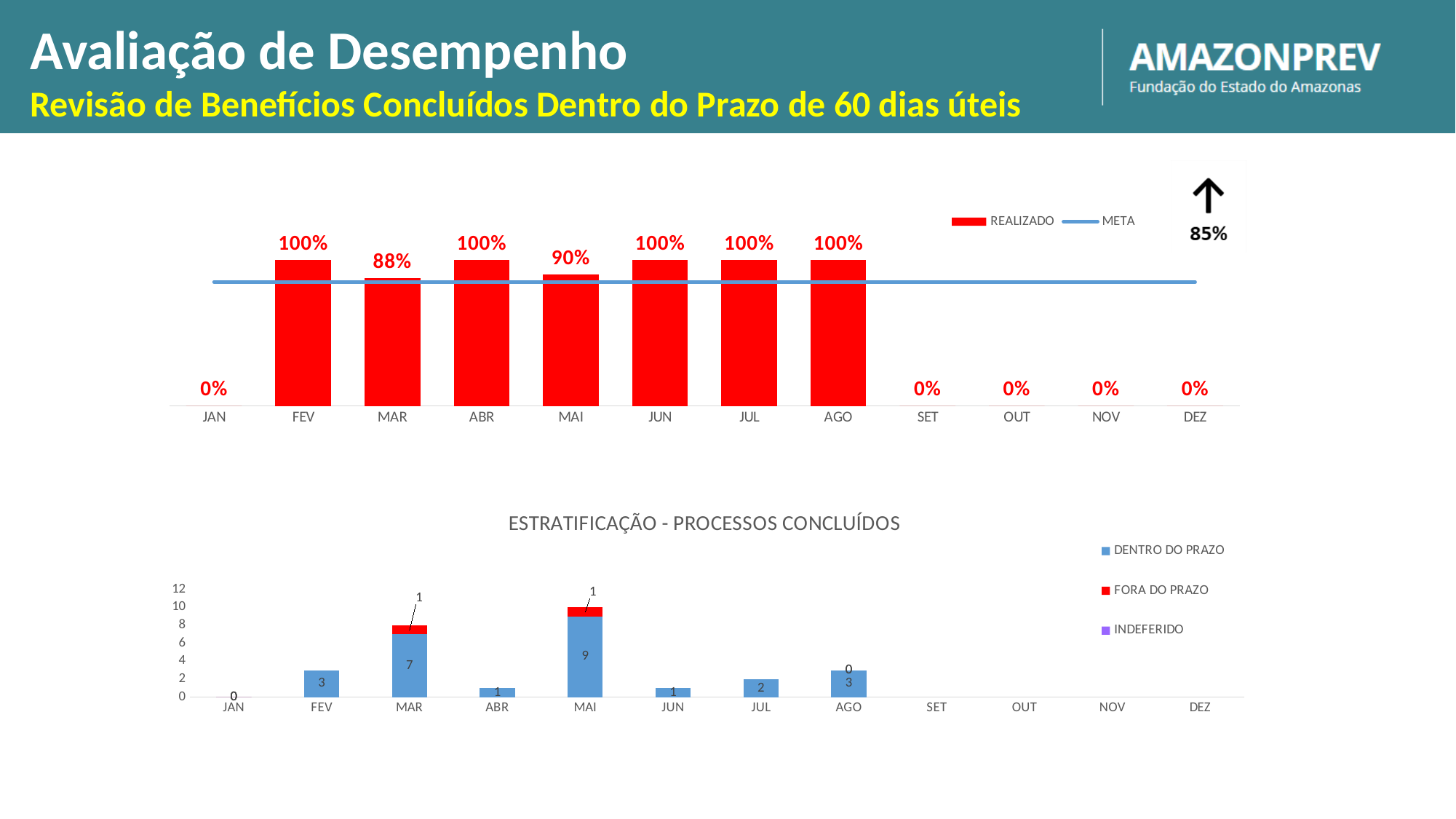
In the top chart, what is the REALIZADO value for MAR? 88% In the top chart, how many series does the legend list? 2 In the top chart, which of MAR or MAI has the higher REALIZADO value? MAI In the chart titled ESTRATIFICAÇÃO - PROCESSOS CONCLUÍDOS, what is the total of the stacked bar for MAR? 8 What kind of chart is the chart titled ESTRATIFICAÇÃO - PROCESSOS CONCLUÍDOS? Stacked bar chart In the top chart, what is the REALIZADO value for MAI? 90% In the chart titled ESTRATIFICAÇÃO - PROCESSOS CONCLUÍDOS, how many series does the legend list? 3 In the chart titled ESTRATIFICAÇÃO - PROCESSOS CONCLUÍDOS, what is the FORA DO PRAZO value for MAR? 1 In the chart titled ESTRATIFICAÇÃO - PROCESSOS CONCLUÍDOS, what is the DENTRO DO PRAZO value for MAI? 9 In the top chart, what is the META value shown? 85% In the top chart, what is the difference between the REALIZADO values for FEV and MAR? 12% In the chart titled ESTRATIFICAÇÃO - PROCESSOS CONCLUÍDOS, which month has the highest DENTRO DO PRAZO value? MAI